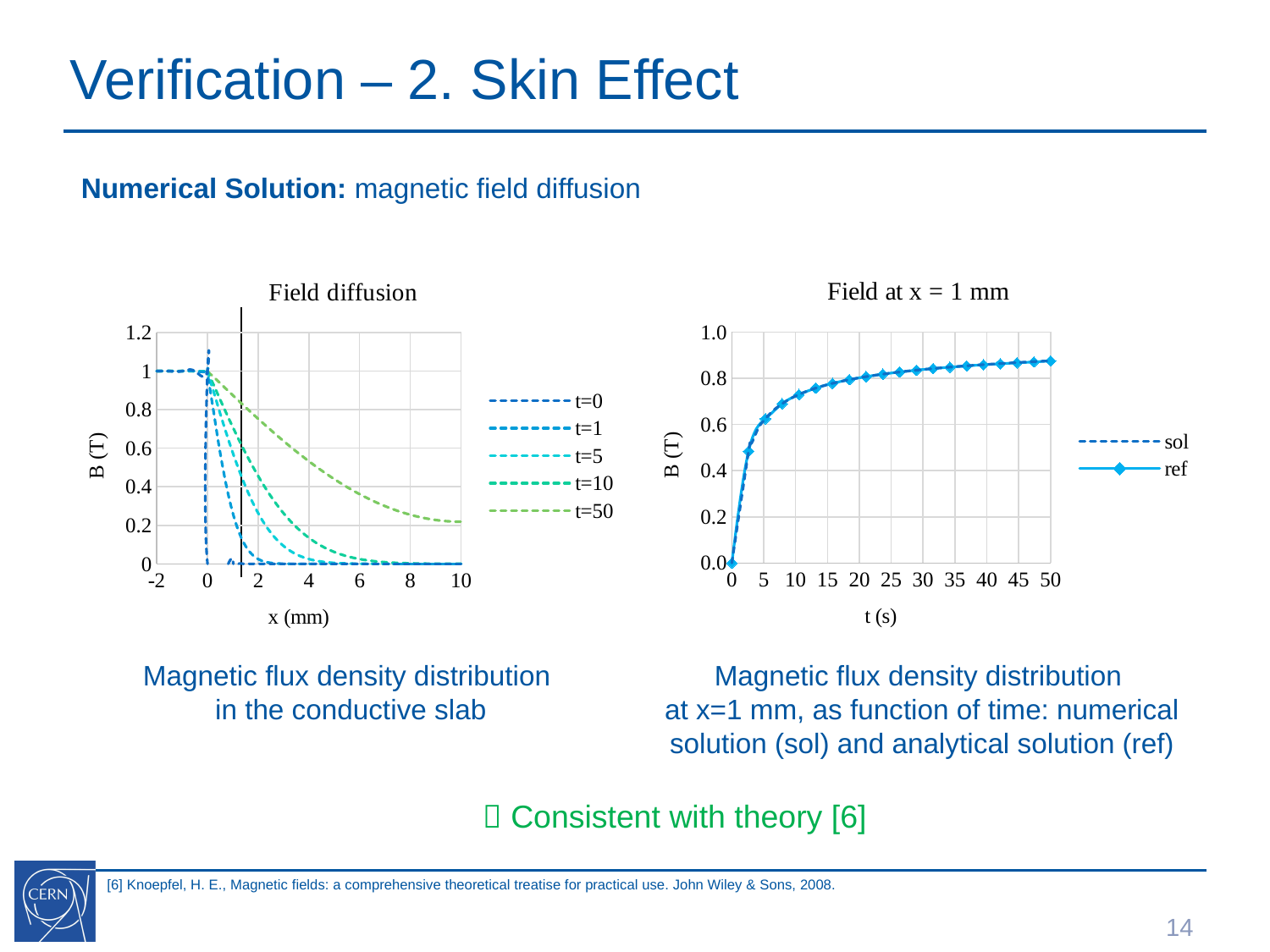
What kind of chart is the 'Field diffusion' chart on the left? line chart In the 'Field at x = 1 mm' chart, do the values rise or fall as t increases? rise In the 'Field at x = 1 mm' chart, is the ref value at t = 5 s greater or less than 0.8? less In the 'Field at x = 1 mm' chart, is the ref value at t = 50 s greater or less than 0.8? greater In the 'Field diffusion' chart, does the t=50 curve rise or fall as x increases from 0 to 10 mm? fall What is the x-axis title of the 'Field at x = 1 mm' chart? t (s) What kind of chart is the 'Field at x = 1 mm' chart on the right? line chart In the 'Field at x = 1 mm' chart, what is the ref value at t = 0 s? 0.0 What are the two legend entries of the 'Field at x = 1 mm' chart? sol and ref How many series does the legend of the 'Field at x = 1 mm' chart list? 2 In the 'Field diffusion' chart, is the t=50 value at x = 10 mm greater or less than 0.4? less How many series does the legend of the 'Field diffusion' chart list? 5